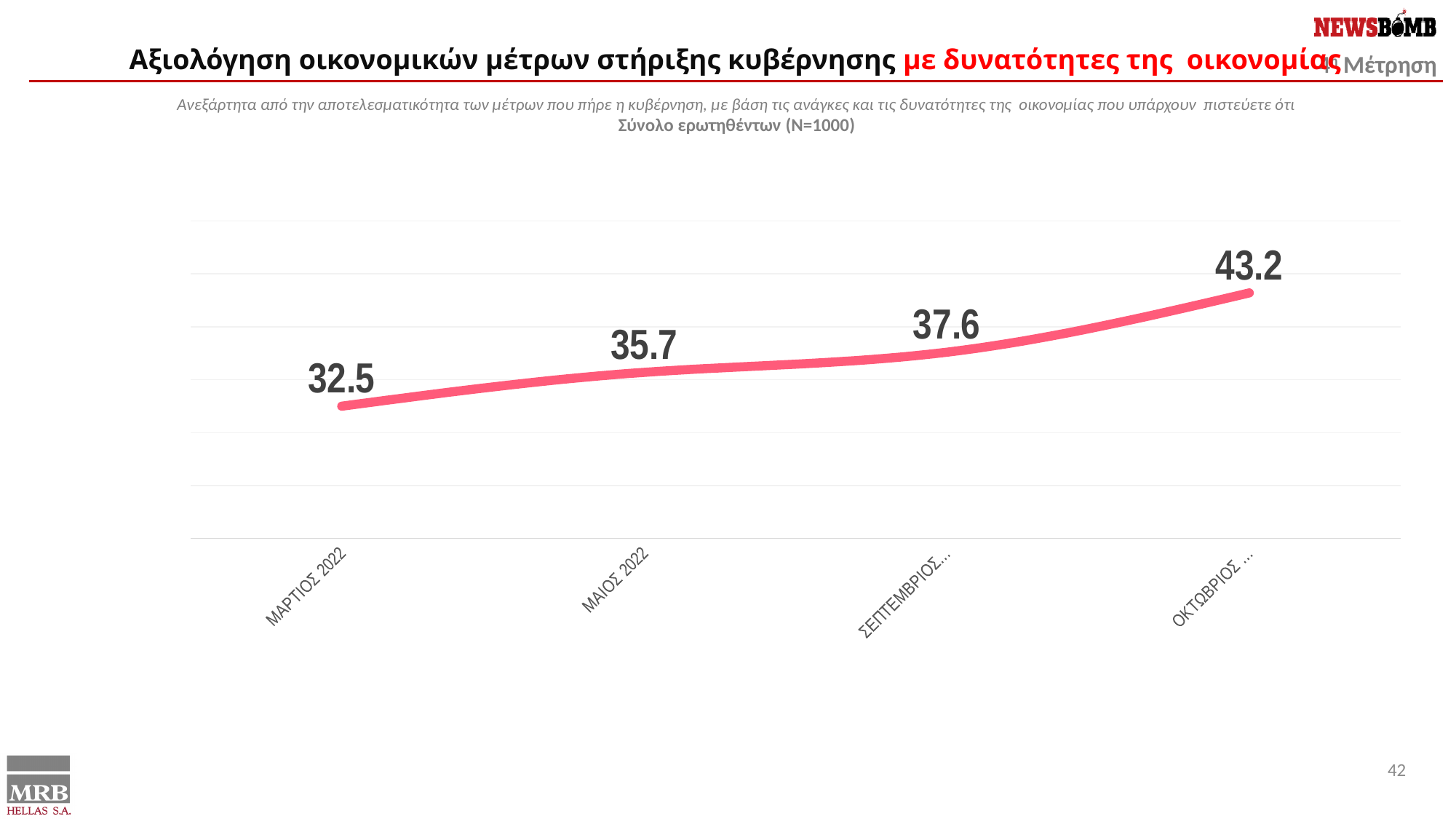
What is the value for the ΣΕΠΤΕΜΒΡΙΟΣ point? 37.6 Do the values rise or fall from ΜΑΡΤΙΟΣ 2022 to ΟΚΤΩΒΡΙΟΣ? rise What is the value for ΜΑΡΤΙΟΣ 2022? 32.5 What kind of chart is shown on the slide? line chart Which is larger, the value for ΜΑΙΟΣ 2022 or the value for ΣΕΠΤΕΜΒΡΙΟΣ? ΣΕΠΤΕΜΒΡΙΟΣ What is the difference between the ΟΚΤΩΒΡΙΟΣ value and the ΜΑΡΤΙΟΣ 2022 value? 10.7 How many data points are plotted on the chart? 4 What is the difference between the ΜΑΙΟΣ 2022 value and the ΜΑΡΤΙΟΣ 2022 value? 3.2 Which point has the lowest value? ΜΑΡΤΙΟΣ 2022 Which point has the highest value? ΟΚΤΩΒΡΙΟΣ What is the value for the ΟΚΤΩΒΡΙΟΣ point? 43.2 What is the value for ΜΑΙΟΣ 2022? 35.7